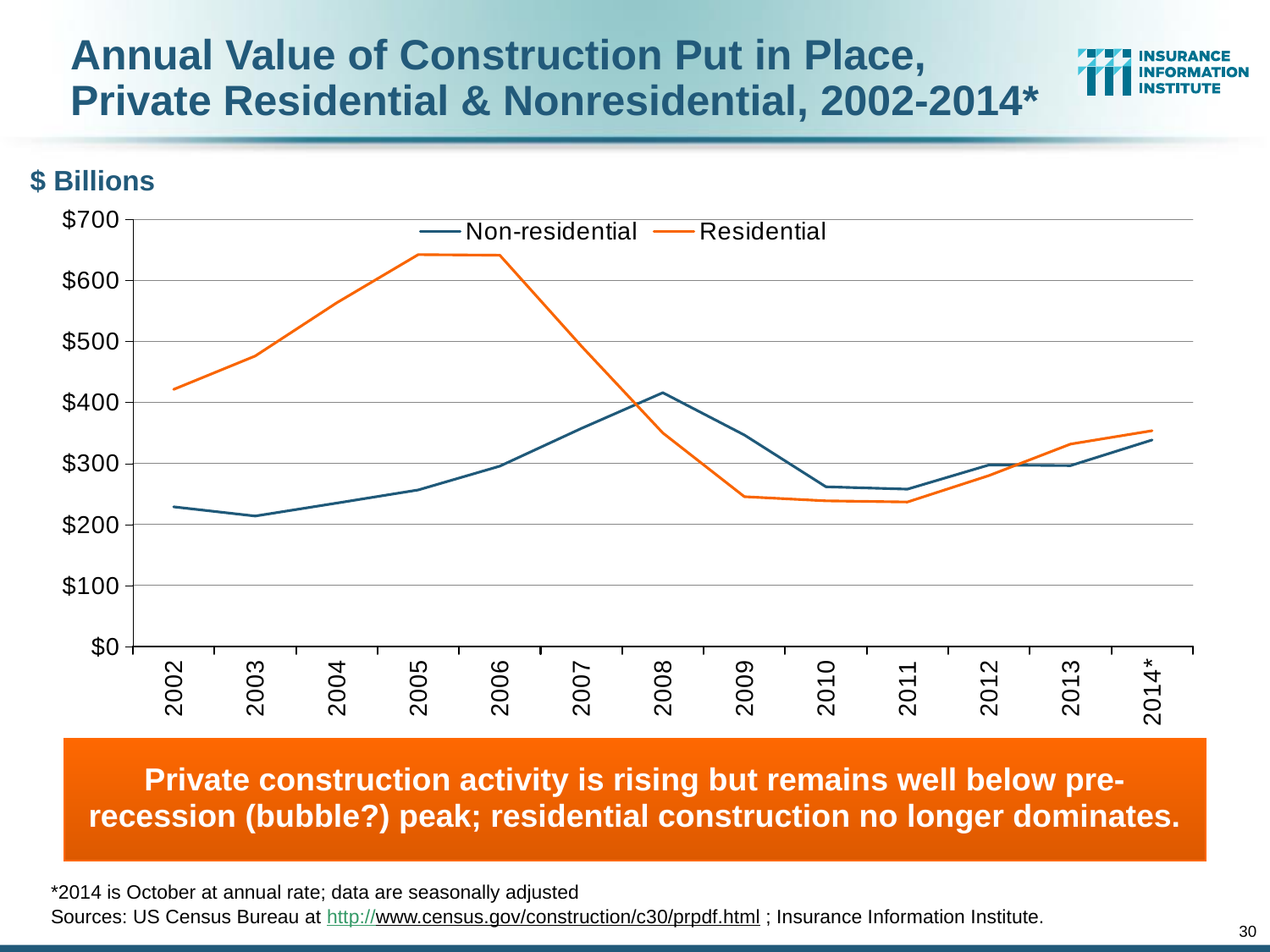
In 2008, which series has the larger value, Residential or Non-residential? Non-residential What kind of chart is shown on the slide? Line chart What unit is shown above the y axis? $ Billions Does the Residential line rise or fall from 2006 to 2009? Fall How many years are plotted along the x axis? 13 How many series does the legend list? 2 In which year is the Non-residential value lowest? 2003 Is the Residential value for 2009 greater or less than $300? less In 2002, which series has the larger value, Residential or Non-residential? Residential In which year does the Non-residential line reach its highest value? 2008 Is the Residential value for 2005 greater or less than $600? greater Is the Non-residential value for 2010 greater or less than $300? less